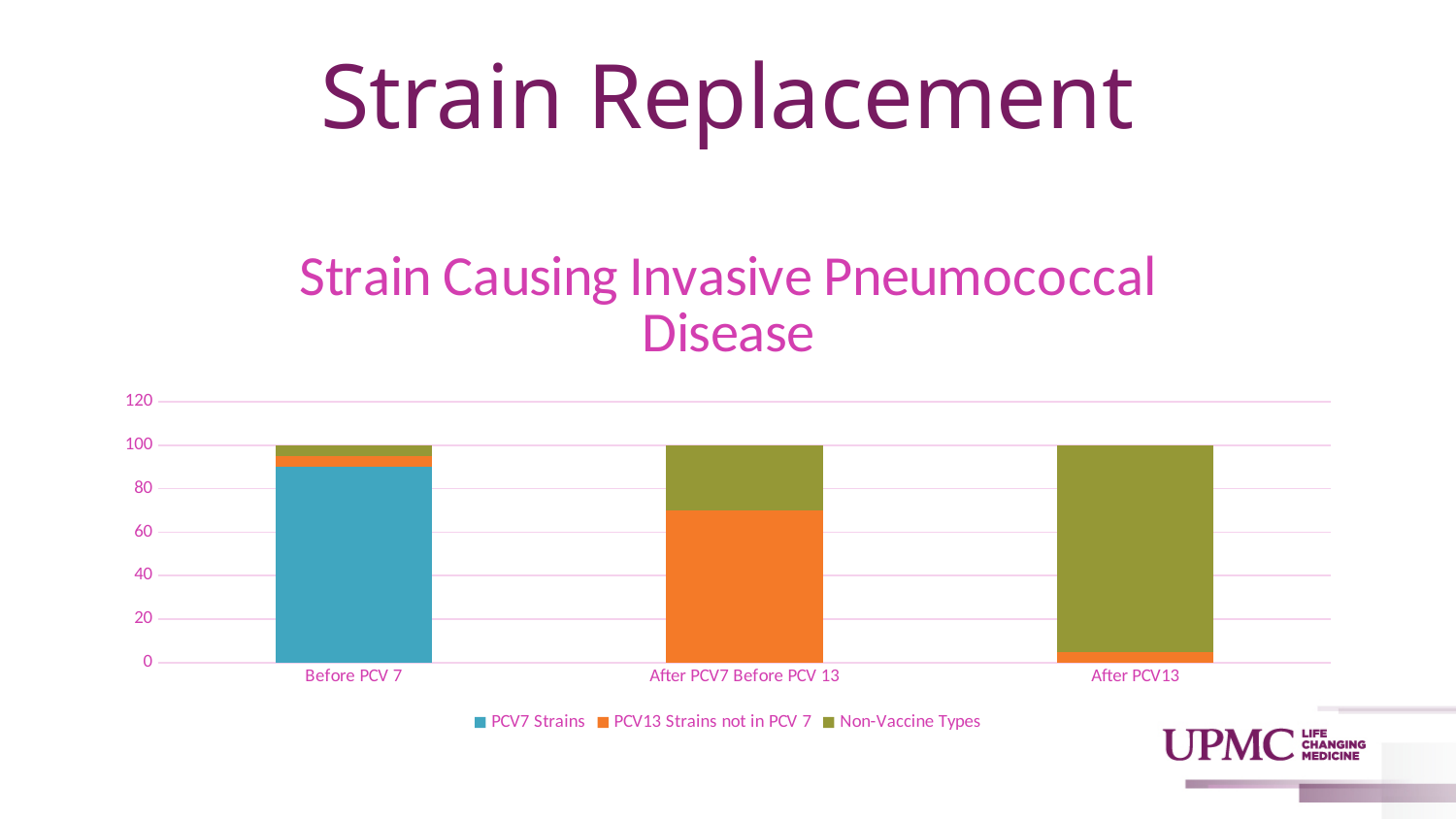
Is the value for PCV13 Strains not in PCV 7 in the After PCV7 Before PCV 13 bar greater or less than 60? greater Which series is shown in green in the chart? Non-Vaccine Types Is the value for PCV7 Strains in the Before PCV 7 bar greater or less than 80? greater What kind of chart is shown on the slide? Stacked bar chart Which category has the largest Non-Vaccine Types segment? After PCV13 Does the Non-Vaccine Types segment rise or fall moving from Before PCV 7 to After PCV13? rise Is the value for Non-Vaccine Types in the After PCV7 Before PCV 13 bar greater or less than 40? less Which category has the smallest Non-Vaccine Types segment? Before PCV 7 How many categories are shown along the x axis of the chart? 3 What is the title of the chart? Strain Causing Invasive Pneumococcal Disease How many series does the chart legend list? 3